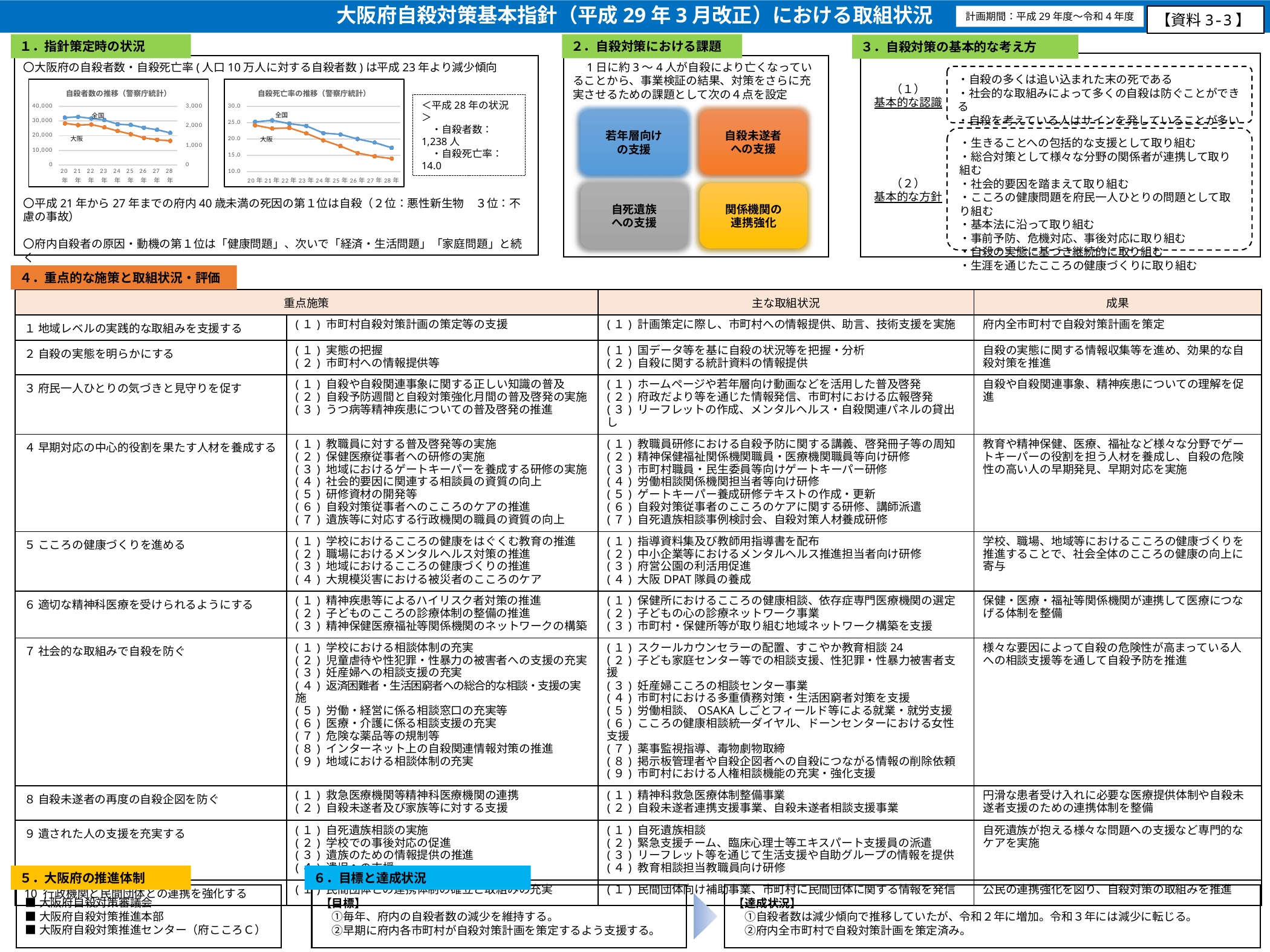
In the chart titled 自殺死亡率の推移（警察庁統計）, is the 全国 value for 28年 greater or less than 20.0? less In the chart titled 自殺死亡率の推移（警察庁統計）, is the 全国 value for 20年 greater or less than 20.0? greater In the chart titled 自殺者数の推移（警察庁統計）, is the 全国 value for 28年 greater or less than 30,000? less In the chart titled 自殺死亡率の推移（警察庁統計）, does the 大阪 line rise or fall from 20年 to 28年? fall What kind of chart is the chart titled 自殺者数の推移（警察庁統計）? line chart In the chart titled 自殺死亡率の推移（警察庁統計）, how many years are plotted along the x axis? 9 What kind of chart is the chart titled 自殺死亡率の推移（警察庁統計）? line chart In the chart titled 自殺死亡率の推移（警察庁統計）, which series has the higher value in 28年, 全国 or 大阪? 全国 In the chart titled 自殺死亡率の推移（警察庁統計）, how many series are plotted? 2 In the chart titled 自殺者数の推移（警察庁統計）, does the 全国 line rise or fall from 20年 to 28年? fall In the chart titled 自殺者数の推移（警察庁統計）, what are the two series plotted? 全国 and 大阪